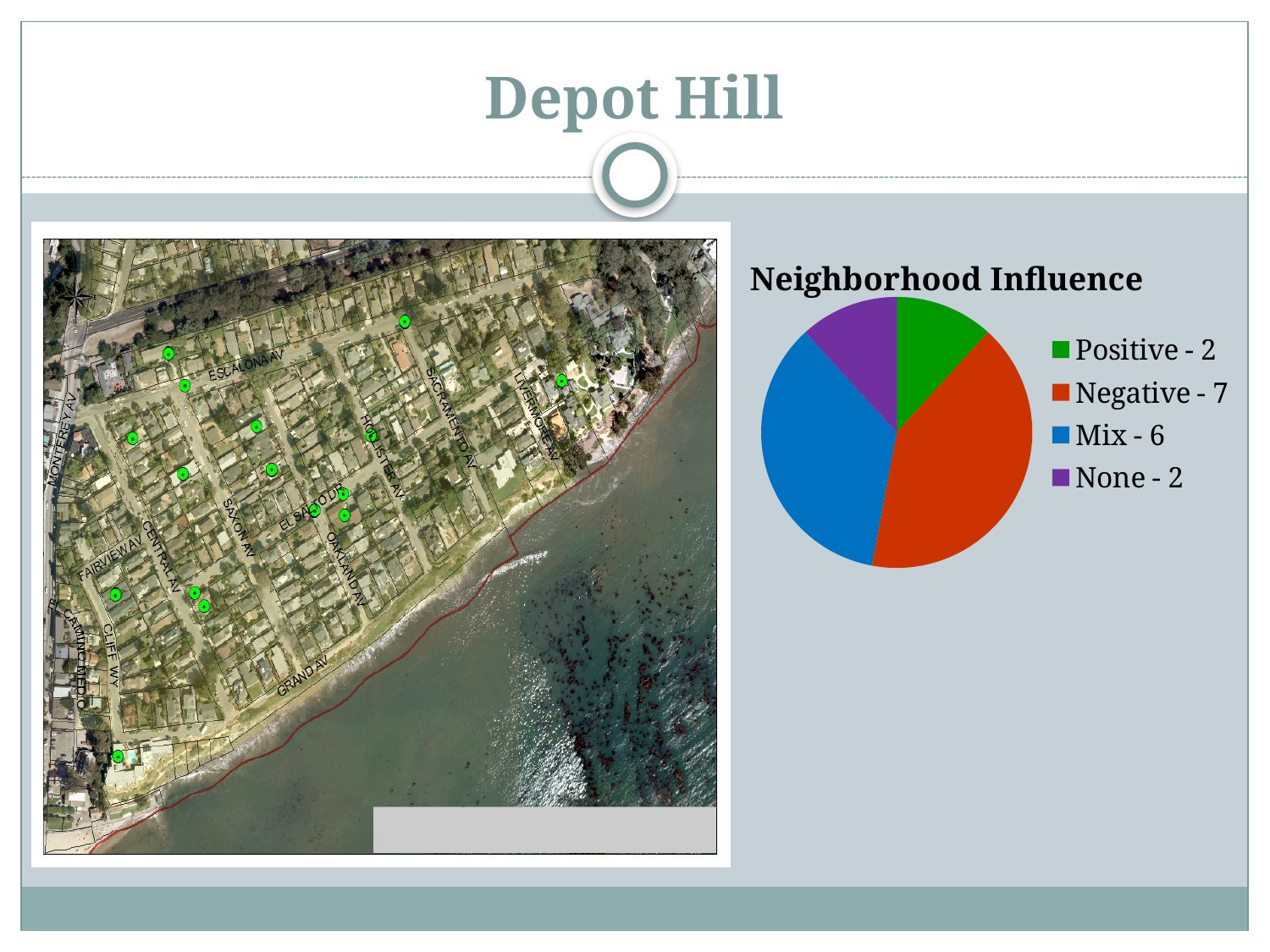
What kind of chart is shown under the heading "Neighborhood Influence"? pie chart In the Neighborhood Influence pie chart, what is the value for Mix? 6 In the Neighborhood Influence pie chart, how much larger is the Mix value than the Positive value? 4 Which category has the largest slice in the Neighborhood Influence pie chart? Negative How many categories does the Neighborhood Influence pie chart show? 4 What colour is the Mix slice in the Neighborhood Influence pie chart? blue In the Neighborhood Influence pie chart, what is the value for None? 2 What is the total of all the values shown in the Neighborhood Influence pie chart legend? 17 In the Neighborhood Influence pie chart, what is the value for Positive? 2 In the Neighborhood Influence pie chart, what is the value for Negative? 7 In the Neighborhood Influence pie chart, what is the difference between the Negative and Mix values? 1 In the Neighborhood Influence pie chart, which is larger: Negative or Mix? Negative